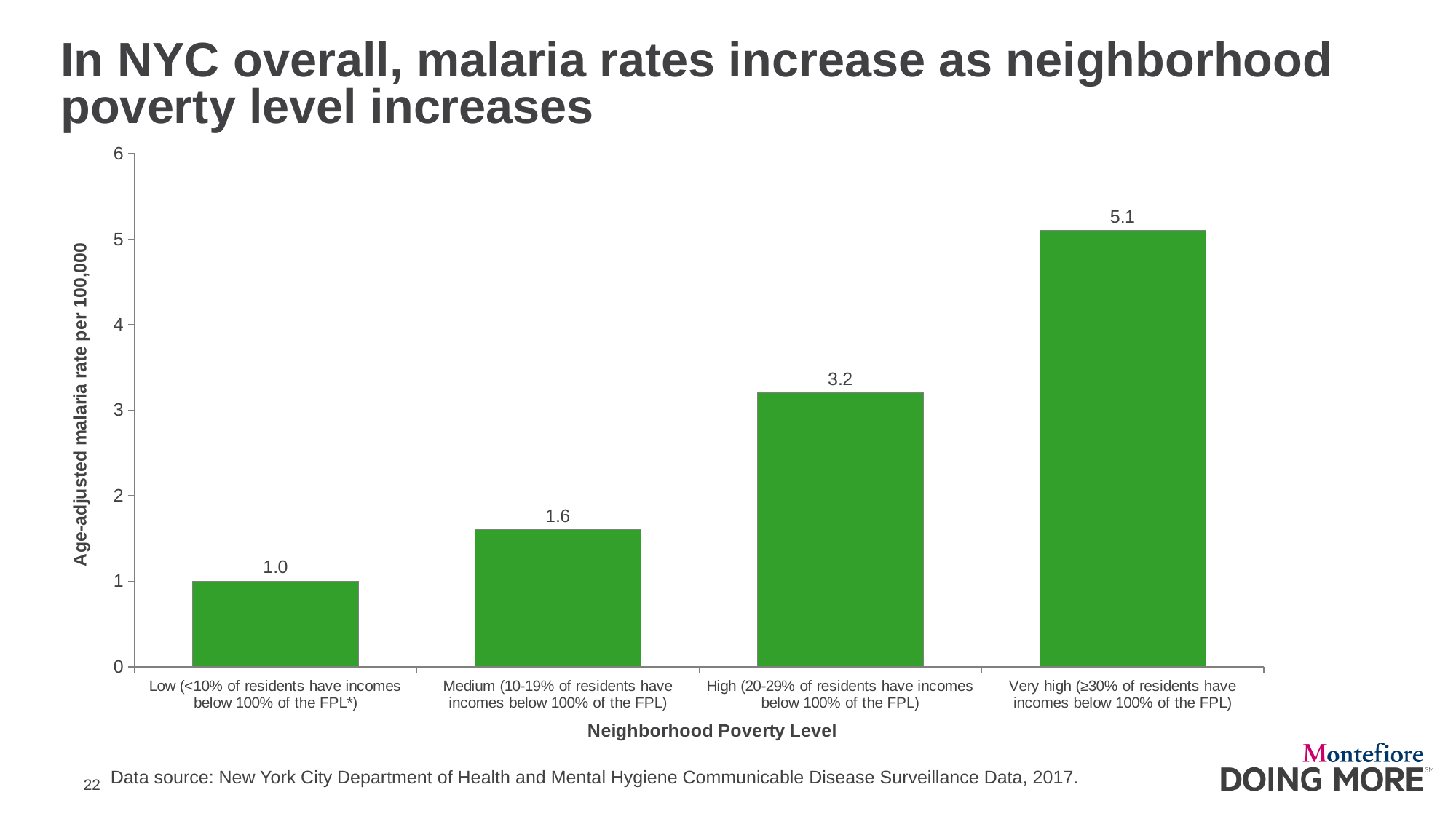
Which has a higher age-adjusted malaria rate, the Medium or the High poverty level? High What is the difference in age-adjusted malaria rate between the Very high and Low poverty levels? 4.1 What is the age-adjusted malaria rate per 100,000 for the Medium neighborhood poverty level? 1.6 What is the age-adjusted malaria rate per 100,000 for the Low neighborhood poverty level? 1.0 What is the age-adjusted malaria rate per 100,000 for the Very high neighborhood poverty level? 5.1 What is the age-adjusted malaria rate per 100,000 for the High neighborhood poverty level? 3.2 Do the malaria rates rise or fall as neighborhood poverty level increases from Low to Very high? Rise Which neighborhood poverty level has the lowest age-adjusted malaria rate? Low How many neighborhood poverty level categories are shown in the chart? 4 What is the difference in age-adjusted malaria rate between the High and Medium poverty levels? 1.6 What kind of chart is shown on the slide? Bar chart Which neighborhood poverty level has the highest age-adjusted malaria rate? Very high